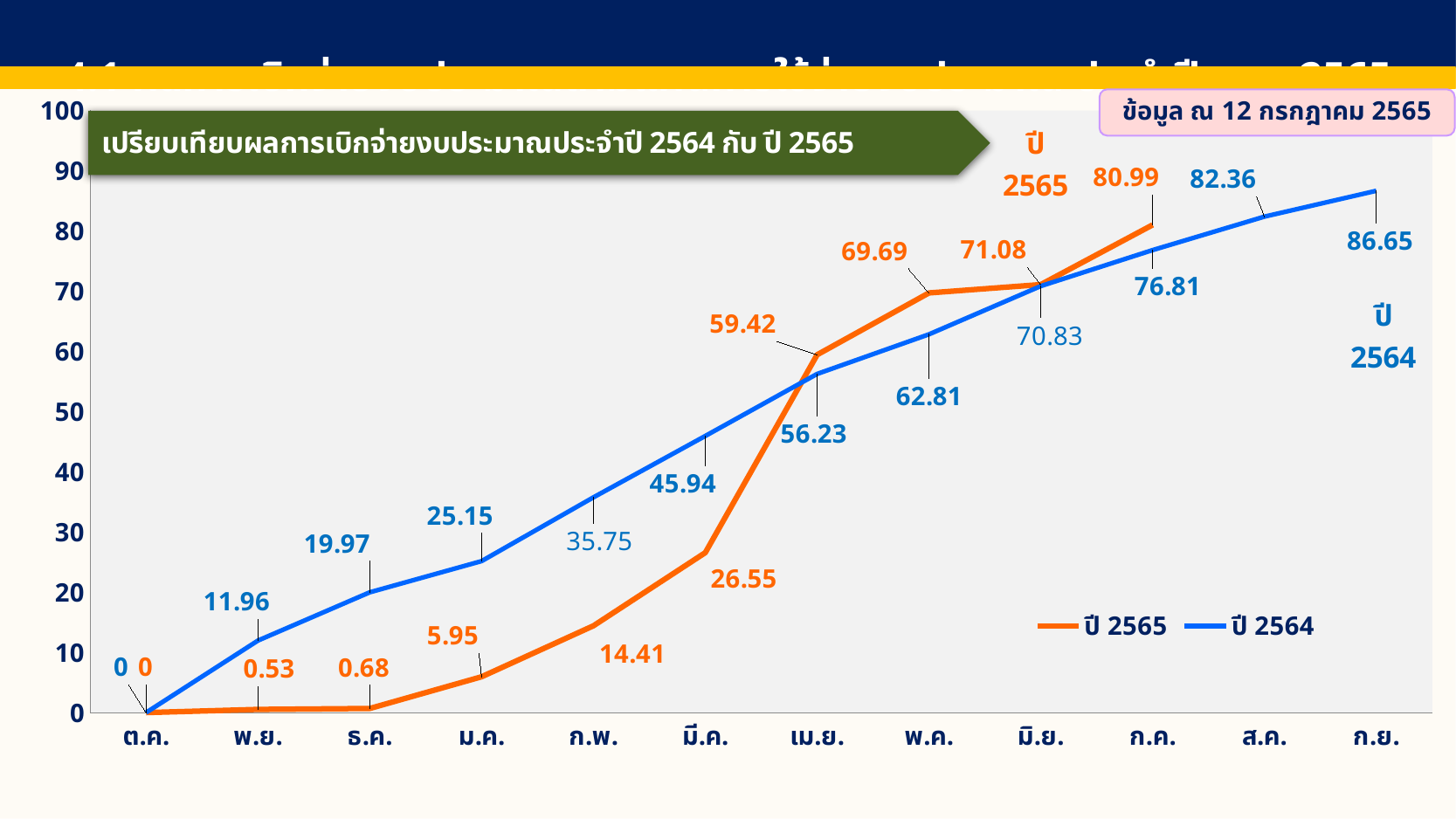
How many series does the legend list? 2 What is the value for ปี 2565 in ก.ค.? 80.99 Which month has the highest value for ปี 2565? ก.ค. How many months are shown on the x axis? 12 Do the values for ปี 2564 rise or fall from ต.ค. to ก.ย.? rise Which colour represents ปี 2565 in the chart? orange What is the value for ปี 2564 in ก.พ.? 35.75 What is the value for ปี 2565 in เม.ย.? 59.42 What is the value for ปี 2564 in ก.ย.? 86.65 What type of chart is shown on the slide? line chart What is the difference between ปี 2564 and ปี 2565 in พ.ย.? 11.43 Which is larger in พ.ค., ปี 2565 or ปี 2564? ปี 2565